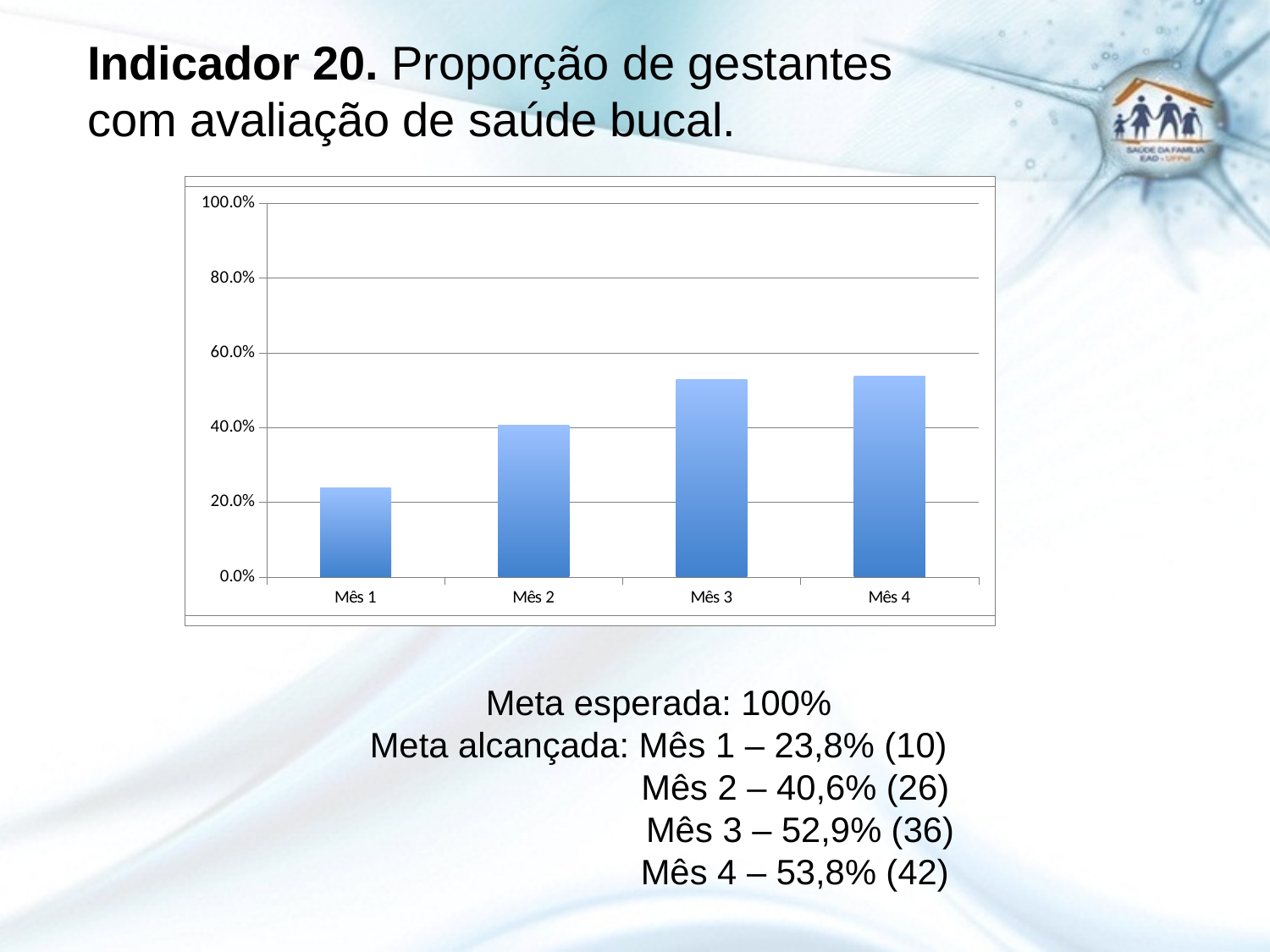
What is the difference between the proportions for Mês 2 and Mês 1 as printed on the slide? 16,8 percentage points Is the value for Mês 3 greater or less than 40.0%? greater Do the bar values rise or fall from Mês 1 to Mês 4? rise How many months (categories) are plotted on the x axis of the chart? 4 Is the value for Mês 1 greater or less than 40.0%? less According to the slide, what proportion was reached in Mês 2? 40,6% What is the expected target (meta esperada) stated on the slide? 100% Which month has the lowest bar in the chart? Mês 1 Is the value for Mês 4 greater or less than 60.0%? less What kind of chart is shown on the slide? bar chart According to the slide, what proportion was reached in Mês 4? 53,8% Which is larger, the value for Mês 1 or the value for Mês 2? Mês 2